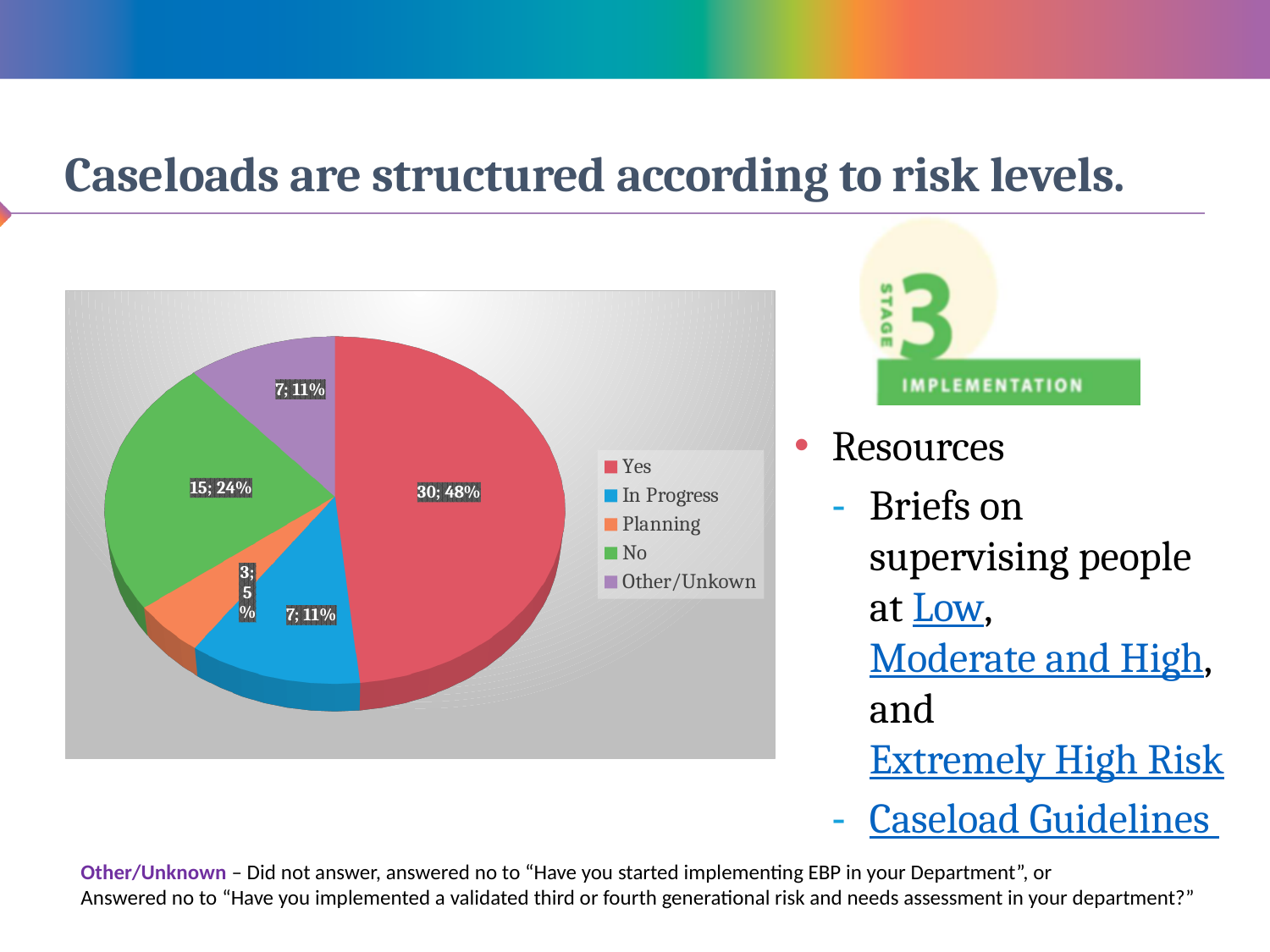
Which category has the largest slice of the pie? Yes How many categories does the pie chart show? 5 What percentage of the pie does the No slice represent? 24% What is the difference between the counts for Yes and No? 15 What percentage of the pie does the Yes slice represent? 48% Which is larger, the No slice or the In Progress slice? No What is the count for the Yes slice of the pie chart? 30 What colour is the Yes slice in the pie chart? red What is the count for the Planning slice? 3 What is the count for the In Progress slice? 7 What kind of chart is shown on the slide? pie chart Which category has the smallest slice of the pie? Planning